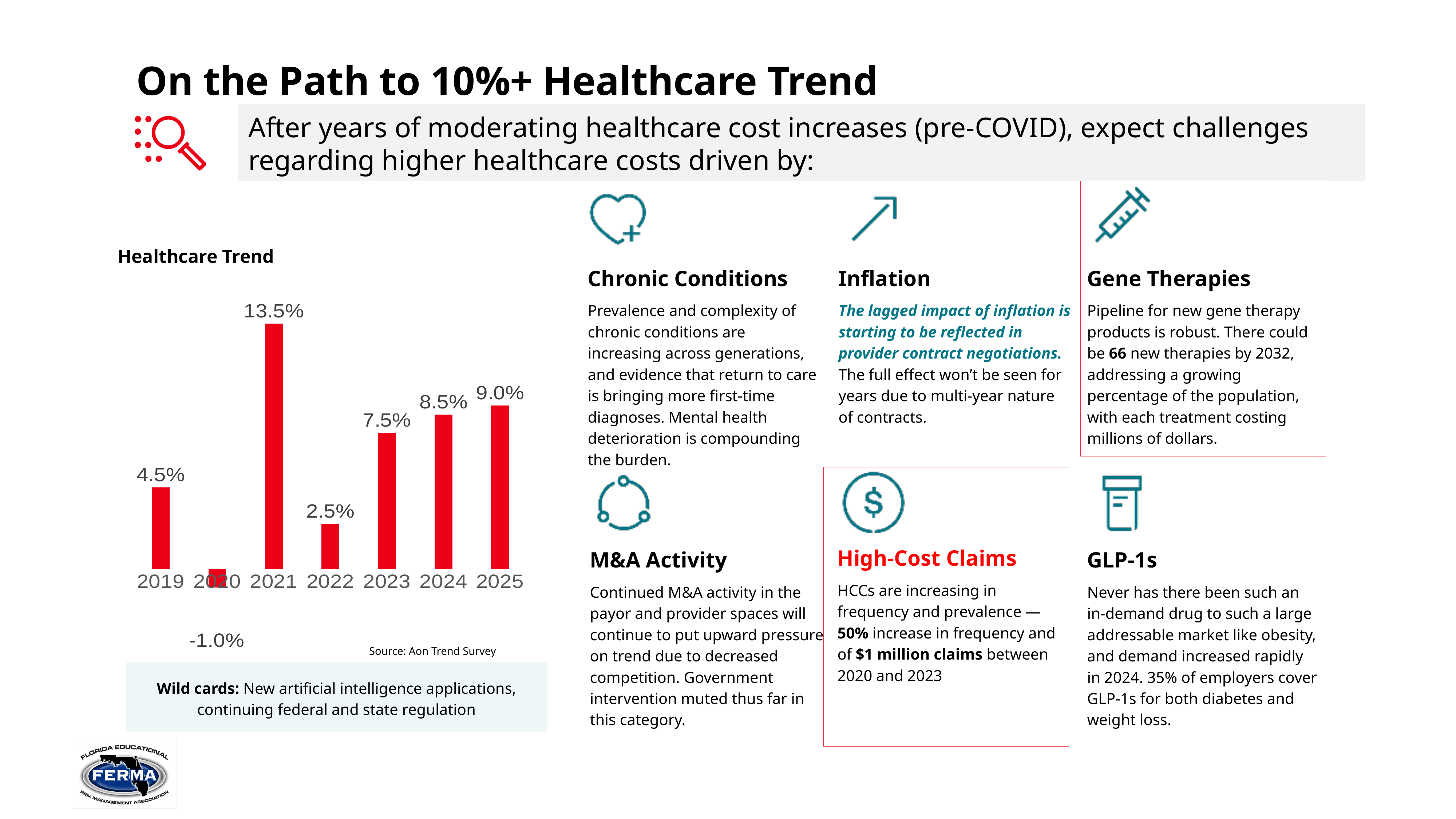
Which year has the highest healthcare trend value? 2021 Which year has a larger healthcare trend value, 2019 or 2023? 2023 What kind of chart is the Healthcare Trend chart? Bar chart What is the difference between the healthcare trend values for 2025 and 2024? 0.5% Which year has the lowest healthcare trend value? 2020 What is the title of the chart on the slide? Healthcare Trend What is the healthcare trend value for 2025? 9.0% What is the healthcare trend value for 2021? 13.5% What is the difference between the healthcare trend values for 2021 and 2022? 11.0% How many years are shown on the Healthcare Trend chart? 7 Do the healthcare trend values rise or fall from 2022 to 2025? Rise What is the healthcare trend value for 2020? -1.0%